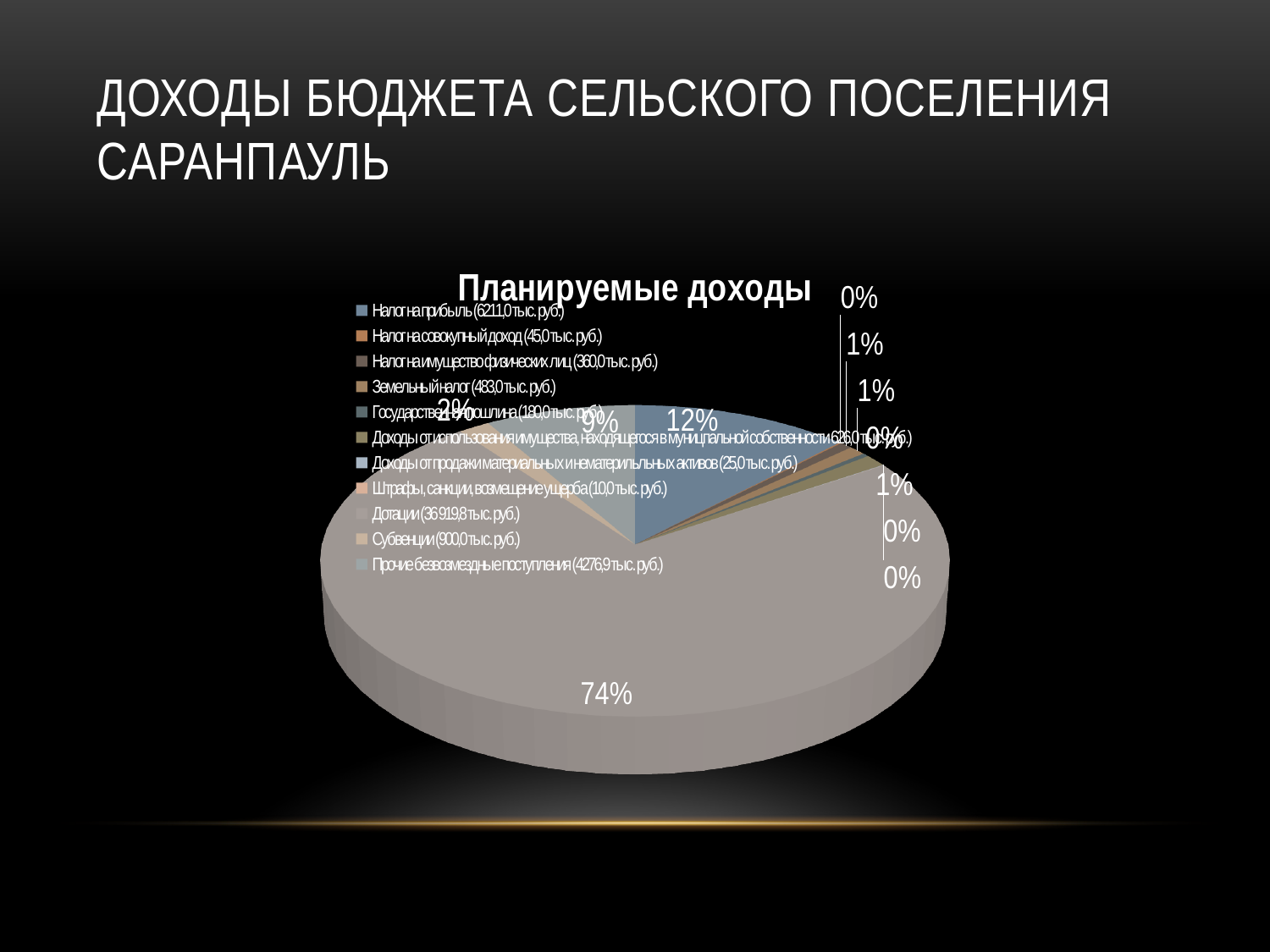
What share of the pie does the largest slice (Дотации) take? 74% What is the difference between the largest slice (74%) and the second largest slice (12%)? 62 percentage points What share of the pie is labelled for the Прочие безвозмездные поступления slice? 9% Is the share of the largest slice greater or less than 50%? greater What is the largest percentage shown on the pie chart? 74% What is the title of the chart? Планируемые доходы What planned amount is given in the legend for Дотации? 36 919,8 тыс. руб. What kind of chart is shown on the slide? pie chart What is the smallest percentage value printed on the pie chart? 0% Which is larger: the 74% slice or the 12% slice? the 74% slice What share of the pie is labelled for the Налог на прибыль slice? 12% How many entries does the chart legend list? 11